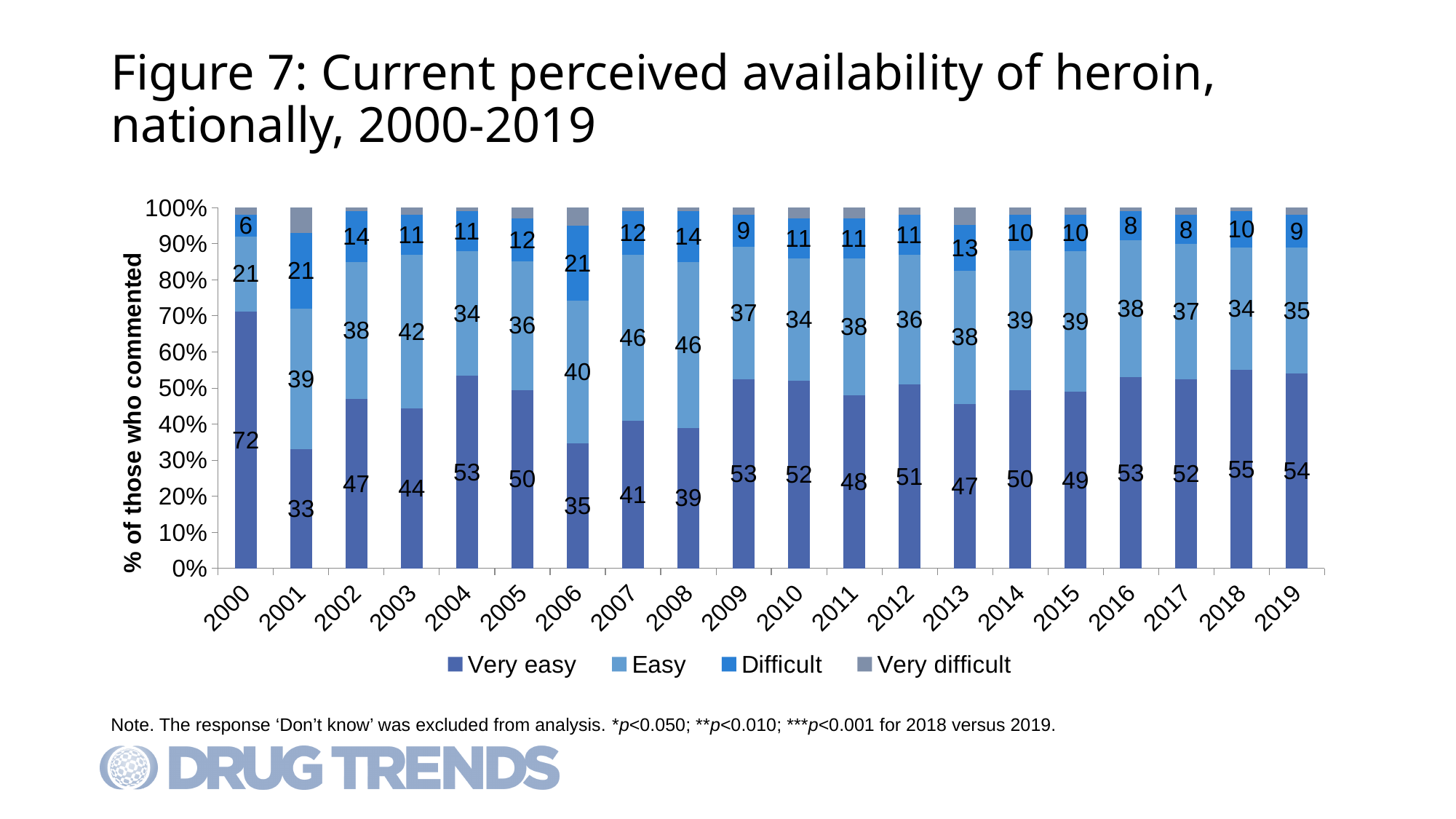
What is the 'Very easy' value for 2019? 54 What kind of chart is shown on the slide? Stacked bar chart What is the label of the y axis? % of those who commented How many series does the legend list? 4 In which year is the 'Very easy' value highest? 2000 What is the 'Difficult' value for 2006? 21 Which is larger, the 'Easy' value for 2003 or the 'Easy' value for 2004? 2003 What is the 'Easy' value for 2007? 46 How many years are shown on the x axis? 20 In which year is the 'Very easy' value lowest? 2001 What is the difference between the 'Very easy' values for 2018 and 2019? 1 What is the 'Very easy' value for 2000? 72